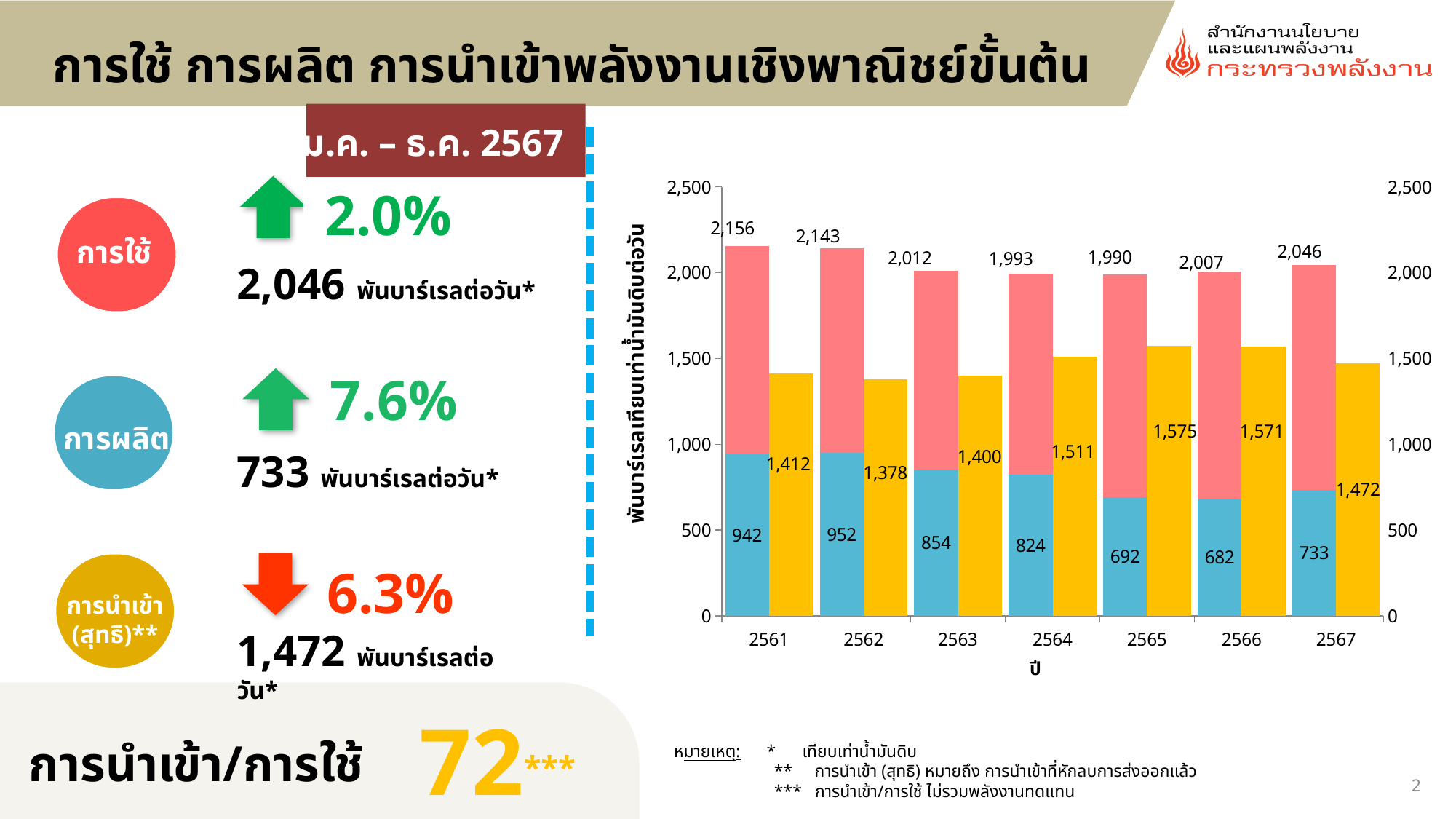
What type of chart is shown on the slide? bar chart What is the value labelled on the blue bar for 2561? 942 What is the difference between the blue bar values for 2561 and 2567? 209 Which year has the lowest value on the blue bars? 2566 What is the title of the x axis of the chart? ปี Which year has the lowest value on the yellow bars? 2562 Which year has the highest value on the yellow bars? 2565 Which year has the highest value labelled at the top of the pink bars? 2561 What is the value labelled at the top of the pink bar for 2567? 2,046 Which year has the larger yellow bar value, 2563 or 2564? 2564 What is the value labelled on the yellow bar for 2564? 1,511 How many years are shown on the x axis of the chart? 7